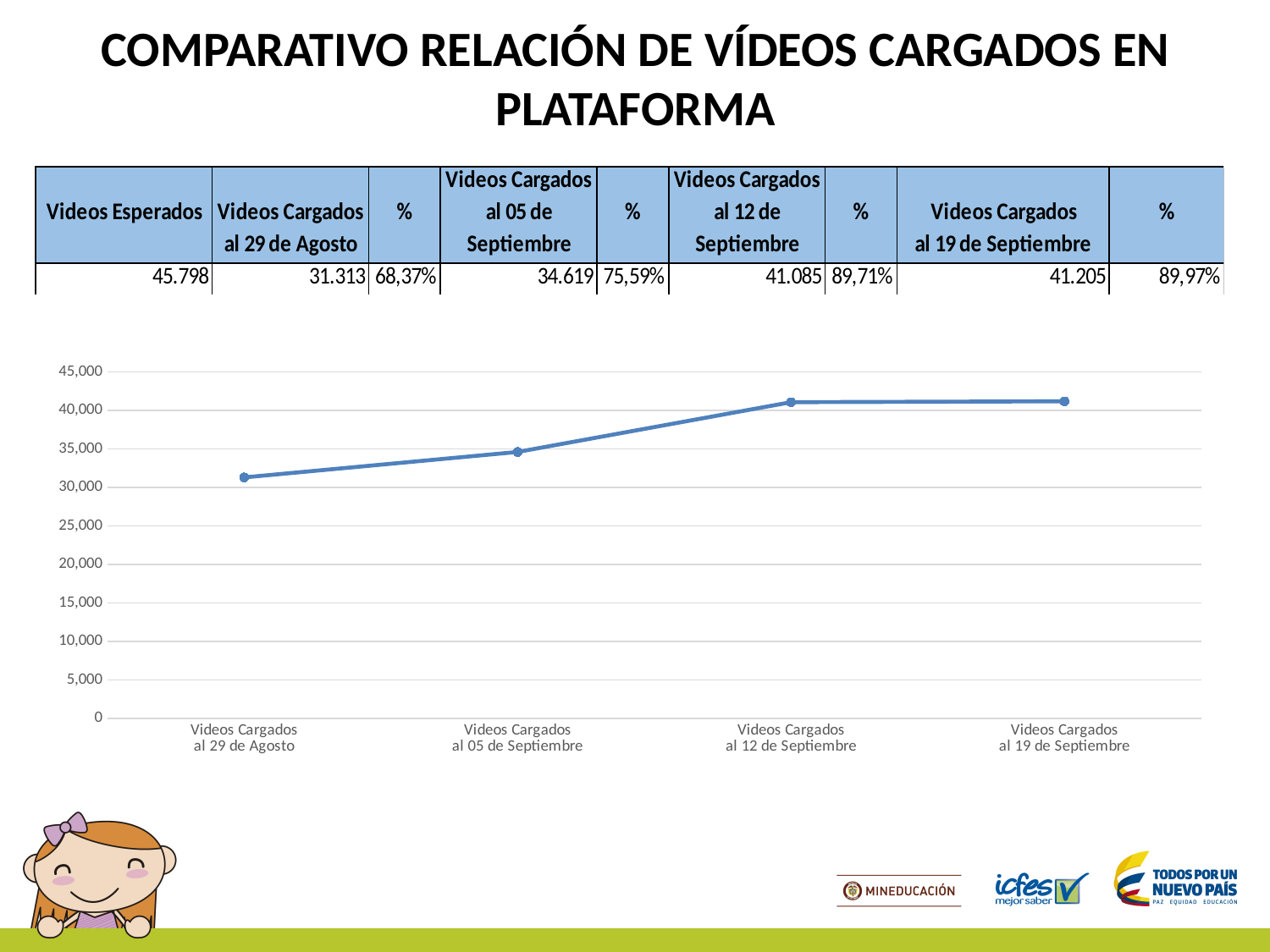
Is the value for 'Videos Cargados al 05 de Septiembre' greater or less than 35,000? less How many data points are plotted on the line chart? 4 Do the values on the line chart rise or fall from 'Videos Cargados al 29 de Agosto' to 'Videos Cargados al 19 de Septiembre'? rise Is the value for 'Videos Cargados al 29 de Agosto' greater or less than 30,000? greater According to the table, what is the difference between the videos loaded as of 05 de Septiembre and as of 29 de Agosto? 3.306 Which category has the lowest value on the line chart? Videos Cargados al 29 de Agosto Which is larger: the value for 'Videos Cargados al 29 de Agosto' or 'Videos Cargados al 12 de Septiembre'? Videos Cargados al 12 de Septiembre Is the value for 'Videos Cargados al 12 de Septiembre' greater or less than 40,000? greater According to the table, how many videos were loaded as of 19 de Septiembre? 41.205 What is the highest value shown on the vertical axis of the line chart? 45,000 According to the table, how many videos were loaded as of 29 de Agosto? 31.313 What kind of chart is shown on the slide? line chart